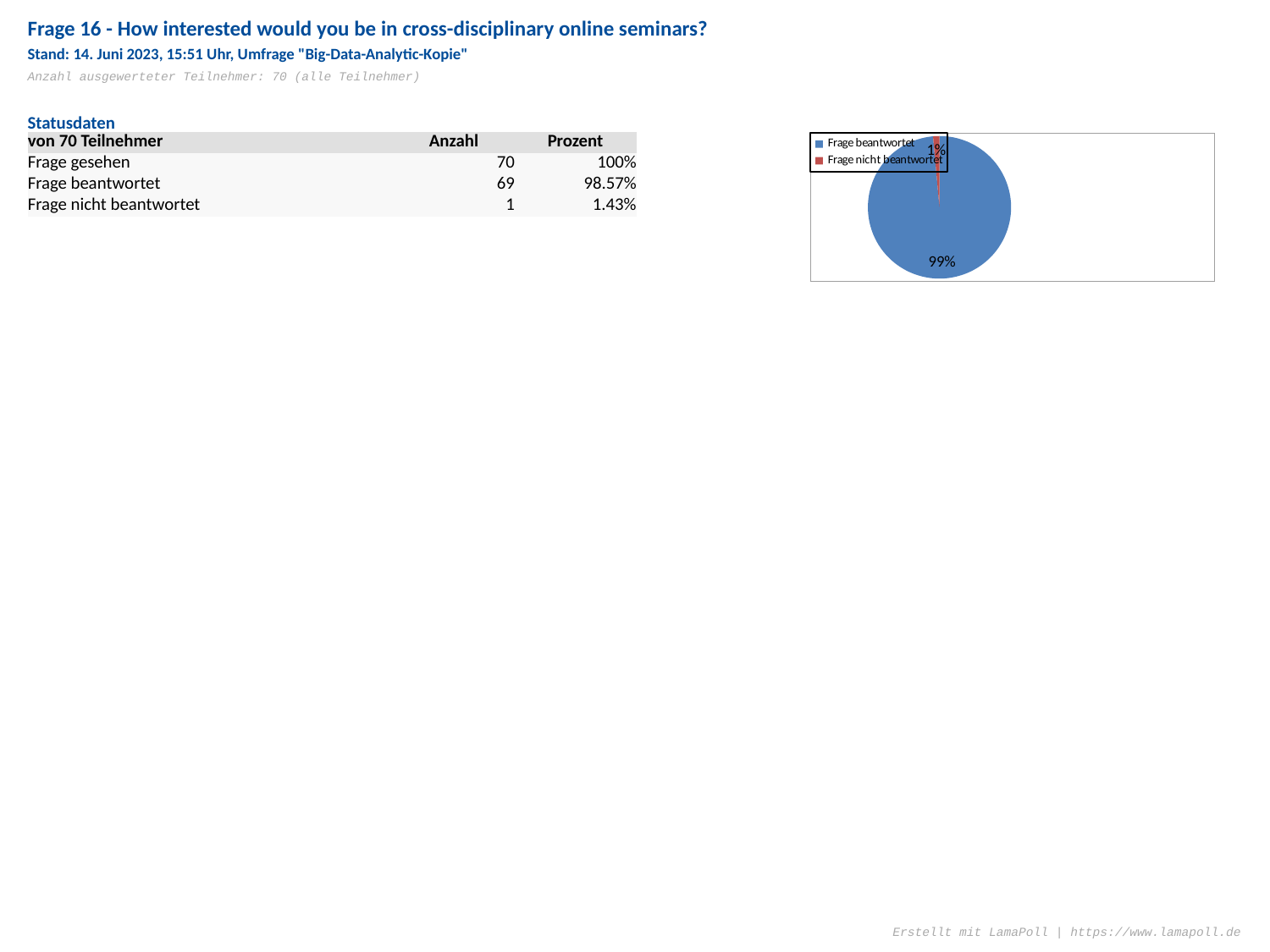
Which is larger in the pie chart, "Frage beantwortet" or "Frage nicht beantwortet"? Frage beantwortet Which slice of the pie is the largest? Frage beantwortet What colour is the "Frage nicht beantwortet" slice in the pie chart? red How many slices does the pie chart have? 2 How many entries does the legend of the pie chart list? 2 What colour is the "Frage beantwortet" slice in the pie chart? blue What share of the pie does "Frage nicht beantwortet" have? 1% What share of the pie does "Frage beantwortet" have? 99% Which slice of the pie is the smallest? Frage nicht beantwortet What kind of chart is shown on the slide? pie chart What is the difference in percentage points between the "Frage beantwortet" and "Frage nicht beantwortet" slices? 98%